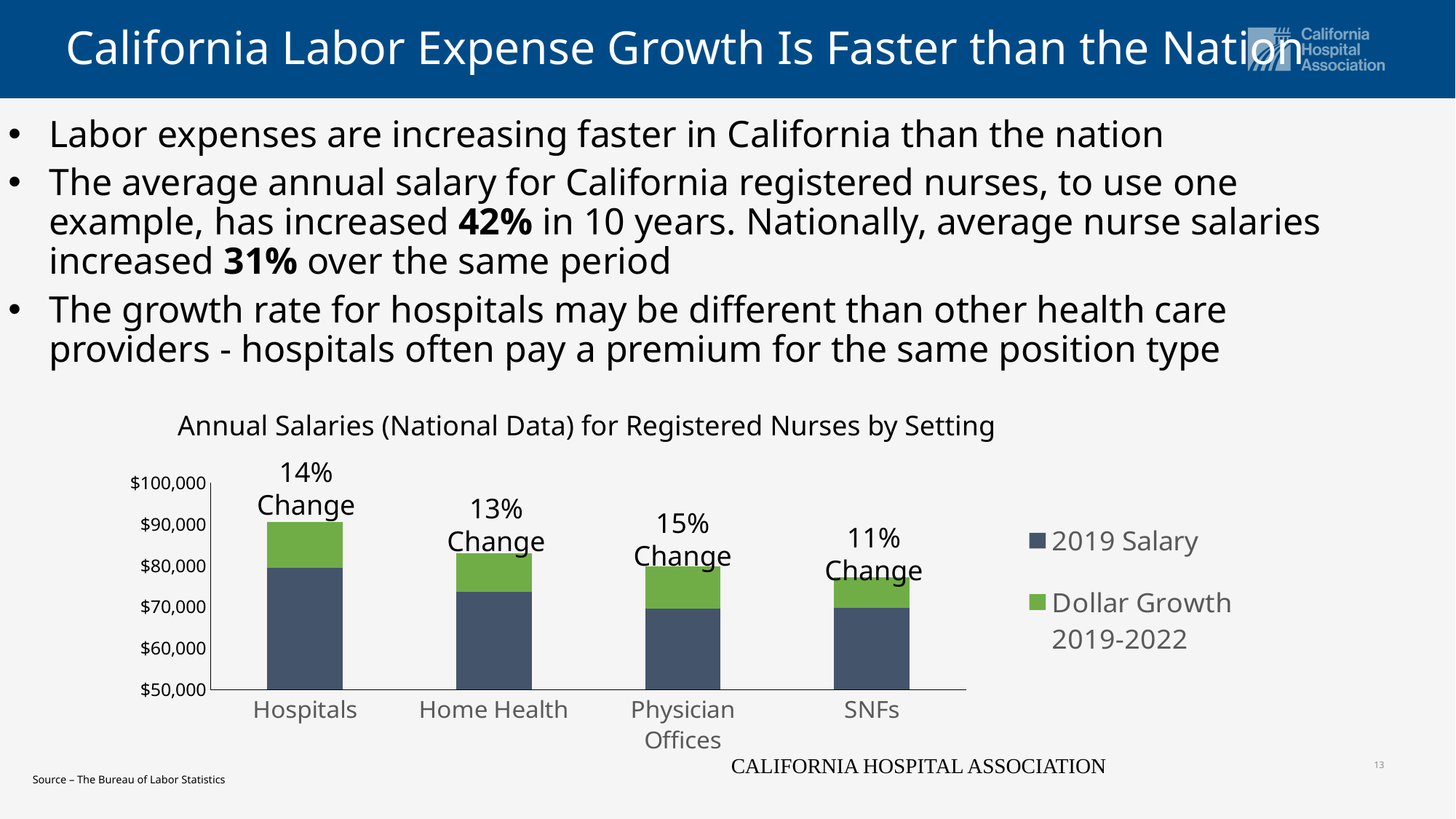
Which setting has the lowest labeled percent change? SNFs What is the title of the chart? Annual Salaries (National Data) for Registered Nurses by Setting Which setting has the tallest total stacked bar? Hospitals How many series does the chart legend list? 2 Which setting has the highest labeled percent change? Physician Offices Is the total stacked bar for SNFs greater or less than $80,000? less What percent change is labeled above the SNFs bar? 11% Change What percent change is labeled above the Hospitals bar? 14% Change Is the 2019 Salary value for Home Health greater or less than $70,000? greater How many settings (categories) are shown on the x axis of the chart? 4 What percent change is labeled above the Physician Offices bar? 15% Change What type of chart is shown on the slide? Stacked bar chart